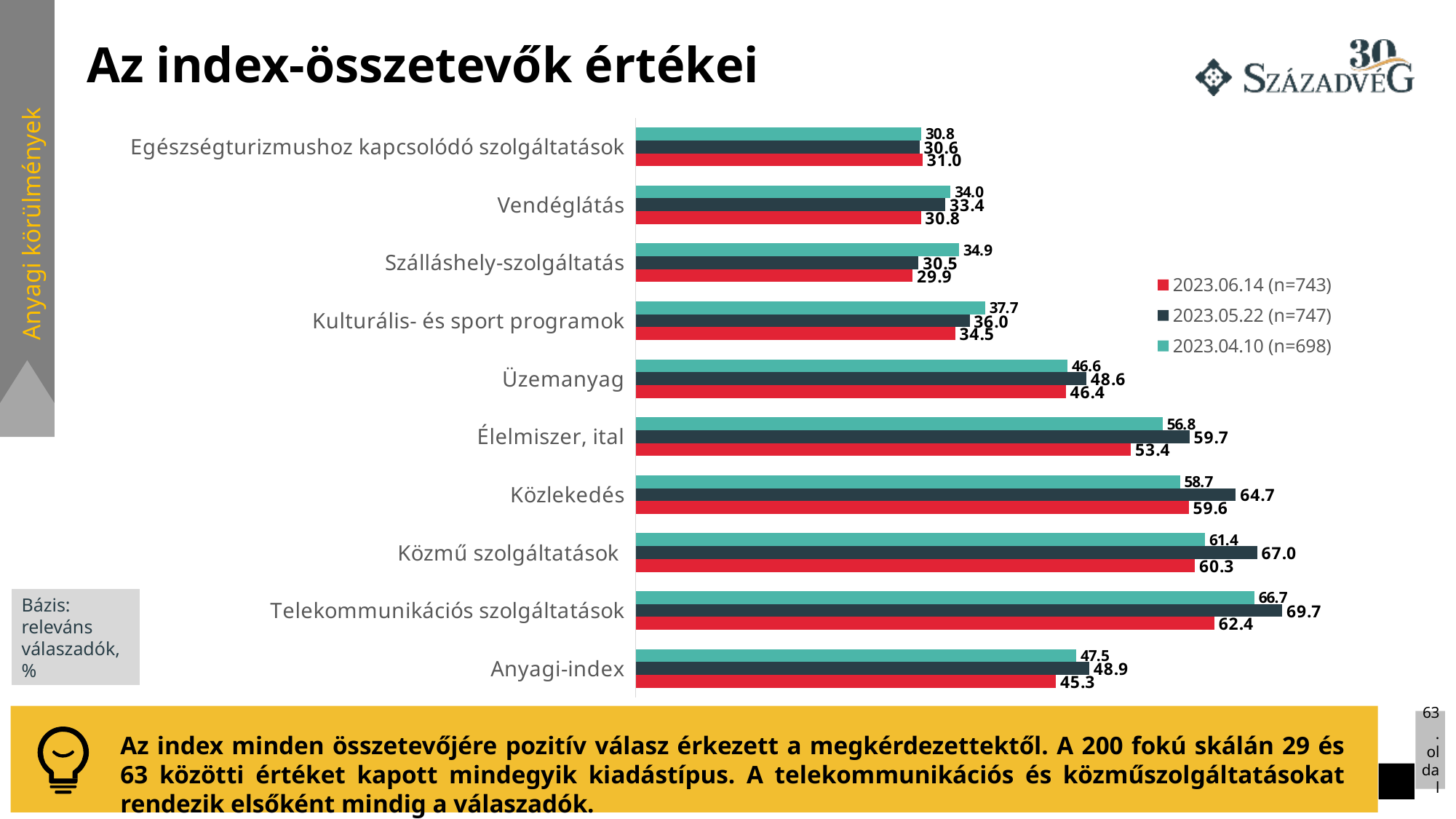
What is the value for Anyagi-index in the 2023.06.14 (n=743) series? 45.3 What is the difference between the 2023.05.22 (n=747) and 2023.06.14 (n=743) values for Közmű szolgáltatások? 6.7 Which category has the highest value in the 2023.05.22 (n=747) series? Telekommunikációs szolgáltatások What is the value for Szálláshely-szolgáltatás in the 2023.04.10 (n=698) series? 34.9 How many categories are shown on the chart? 10 What kind of chart is shown on the slide? Bar chart Which category has the lowest value in the 2023.06.14 (n=743) series? Szálláshely-szolgáltatás What is the value for Üzemanyag in the 2023.05.22 (n=747) series? 48.6 Which is larger for Közlekedés: the 2023.06.14 (n=743) value or the 2023.04.10 (n=698) value? 2023.06.14 (n=743) What is the value for Telekommunikációs szolgáltatások in the 2023.06.14 (n=743) series? 62.4 Which series is shown in red in the legend? 2023.06.14 (n=743) How many series does the legend list? 3